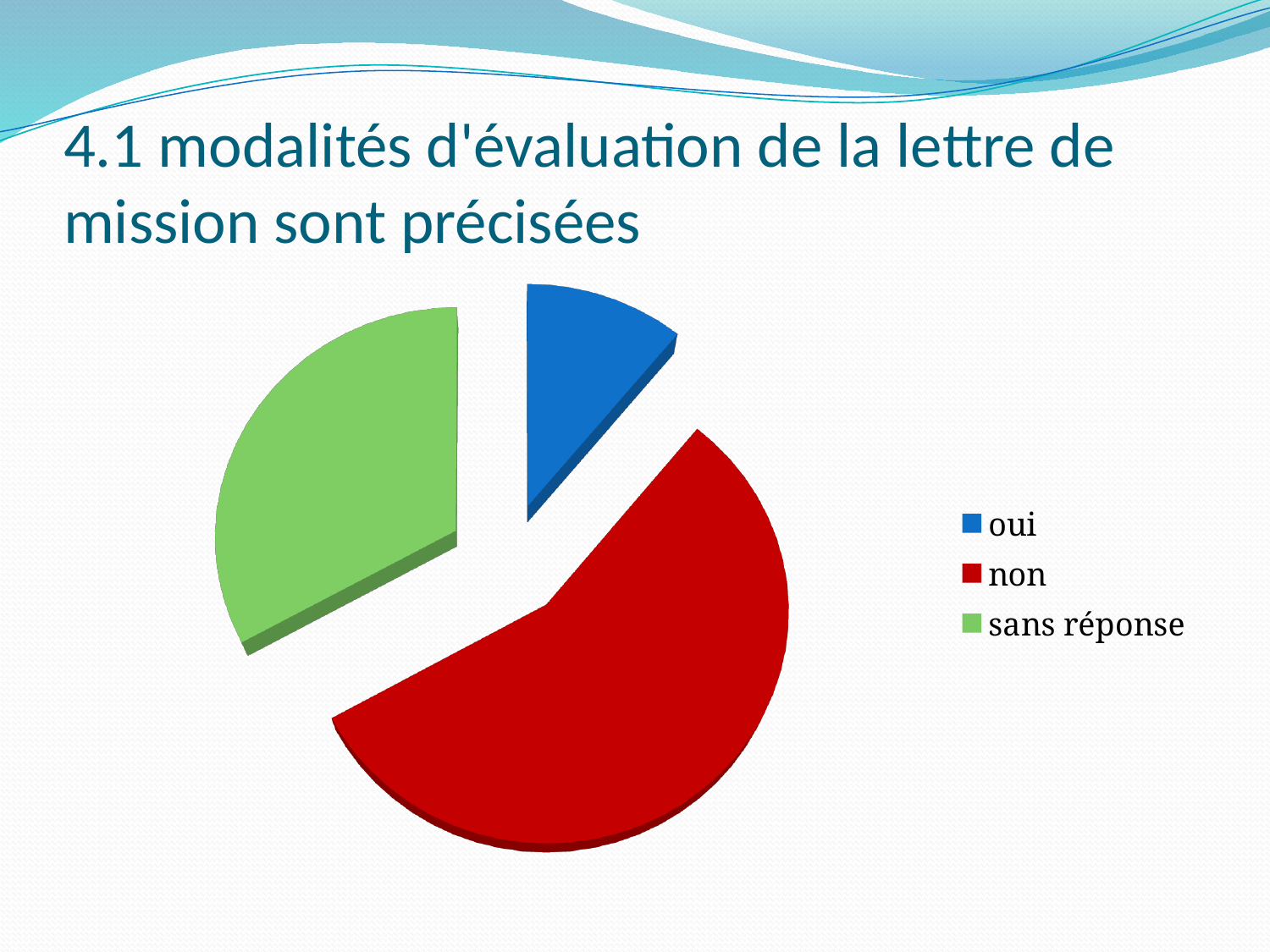
Which slice is larger, "non" or "sans réponse"? non What colour is the "oui" slice? blue What colour is the "sans réponse" slice? green How many entries does the legend list? 3 Which category has the smallest slice of the pie? oui How many slices does the pie chart have? 3 Which slice is larger, "non" or "oui"? non Which category has the largest slice of the pie? non Which slice is larger, "sans réponse" or "oui"? sans réponse What kind of chart is shown on the slide? pie chart